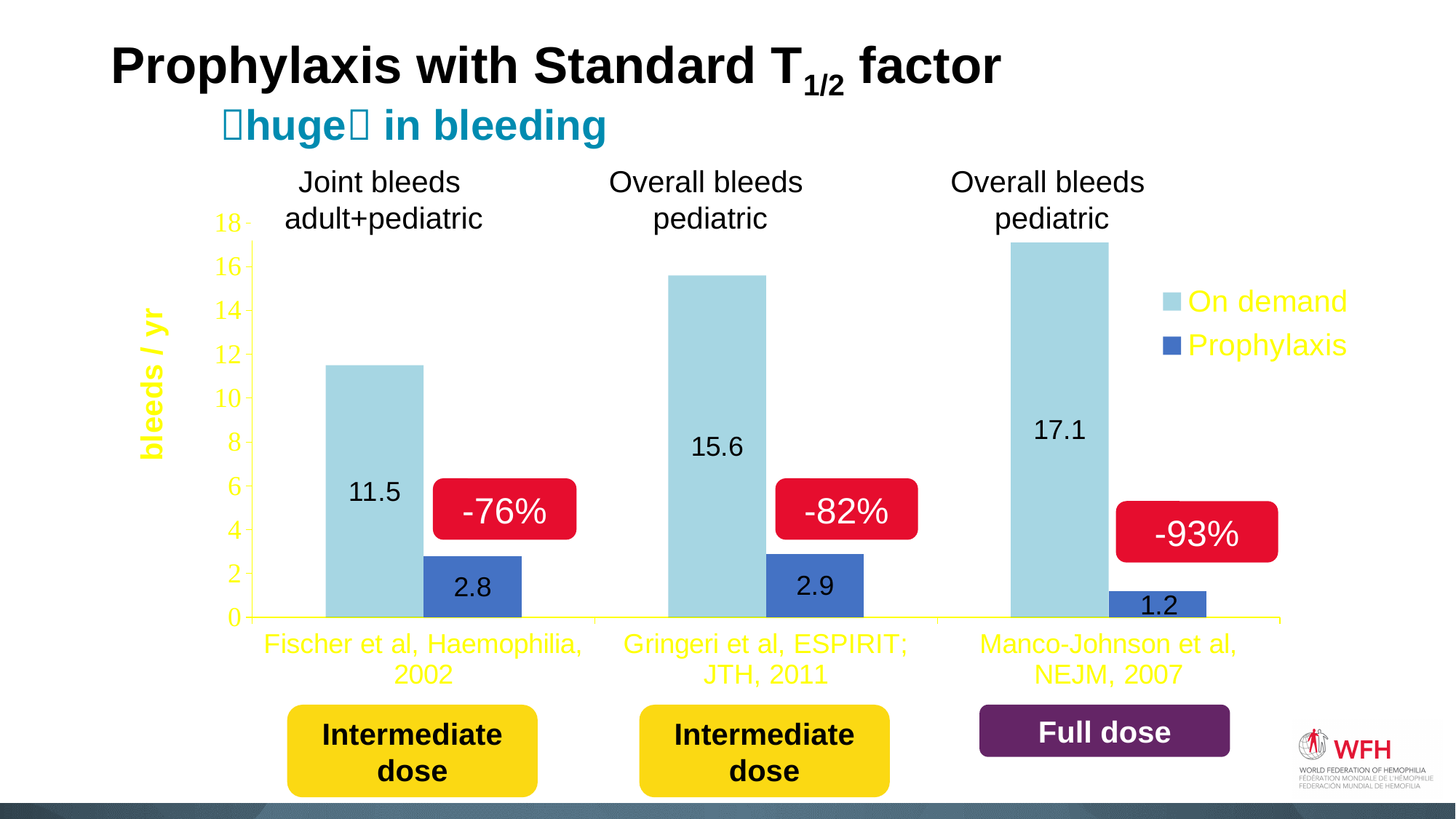
What is the On demand value for Fischer et al, Haemophilia, 2002? 11.5 What is the label on the y axis? bleeds / yr Which is larger, the On demand value for Fischer et al, Haemophilia, 2002 or the On demand value for Gringeri et al, ESPIRIT; JTH, 2011? Gringeri et al, ESPIRIT; JTH, 2011 What is the Prophylaxis value for Gringeri et al, ESPIRIT; JTH, 2011? 2.9 How many series does the legend list? 2 Is the On demand value for Manco-Johnson et al, NEJM, 2007 greater or less than 16? greater Which study has the highest On demand value? Manco-Johnson et al, NEJM, 2007 Which study has the lowest Prophylaxis value? Manco-Johnson et al, NEJM, 2007 What is the difference between the On demand and Prophylaxis values for Gringeri et al, ESPIRIT; JTH, 2011? 12.7 What kind of chart is shown? bar chart What is the Prophylaxis value for Manco-Johnson et al, NEJM, 2007? 1.2 How many studies are shown on the x axis? 3